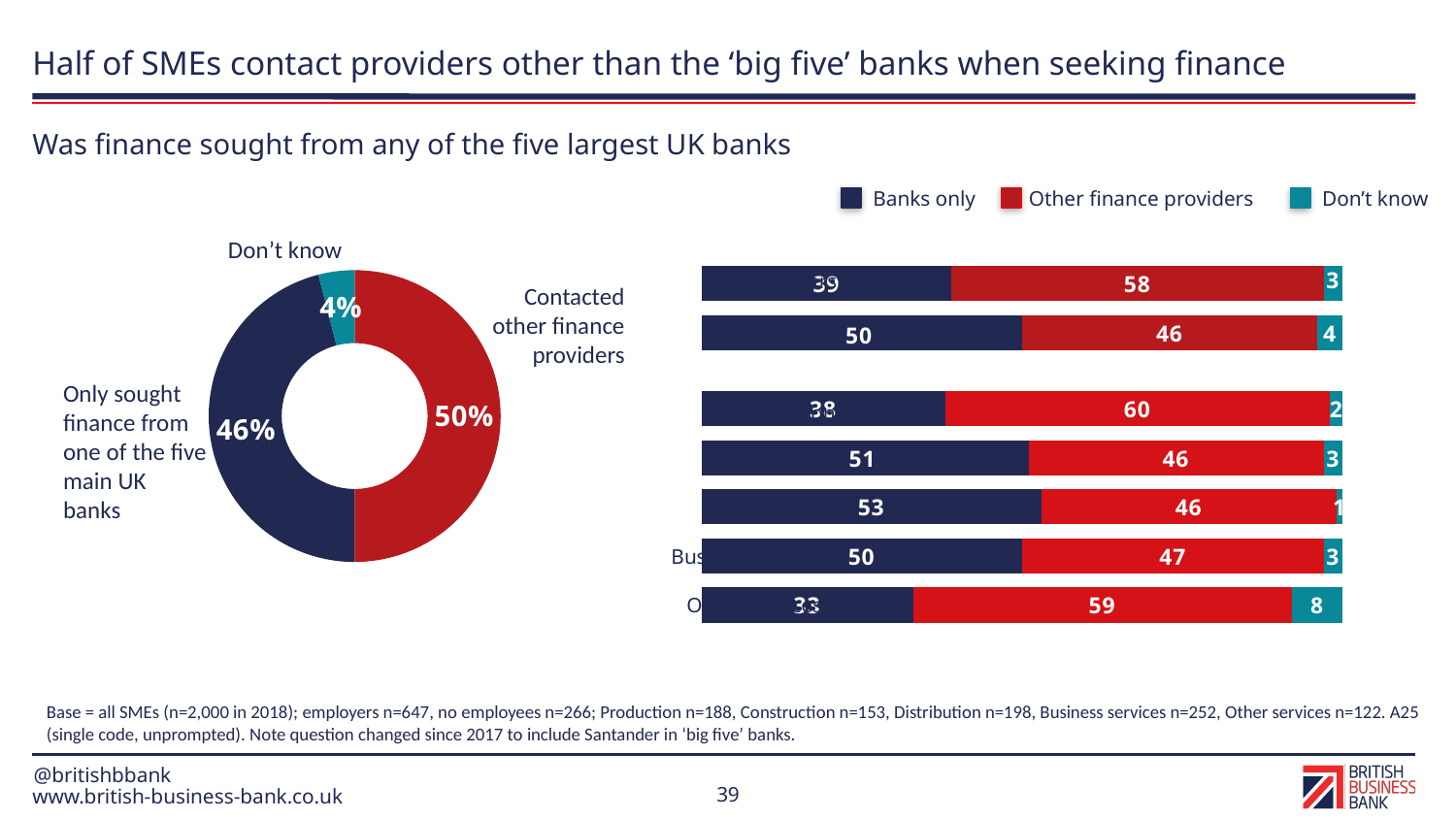
What type of chart is shown on the left of the slide? Donut (pie) chart How many bars are there in the stacked bar chart on the right? 7 In the stacked bar chart on the right, what is the 'Banks only' value for the top bar? 39 In the stacked bar chart on the right, what is the total of the top bar's three segments? 100 In the donut chart on the left, which segment is the largest? Contacted other finance providers In the donut chart on the left, what percentage of SMEs only sought finance from one of the five main UK banks? 46% In the donut chart on the left, what percentage of SMEs contacted other finance providers? 50% In the stacked bar chart on the right, which bar has the highest 'Don't know' value? The bottom bar (8) In the donut chart on the left, what is the difference in percentage points between 'Contacted other finance providers' and 'Only sought finance from one of the five main UK banks'? 4 percentage points In the donut chart on the left, which segment is the smallest? Don't know In the donut chart on the left, what percentage answered 'Don't know'? 4% How many series does the legend of the stacked bar chart on the right list? 3